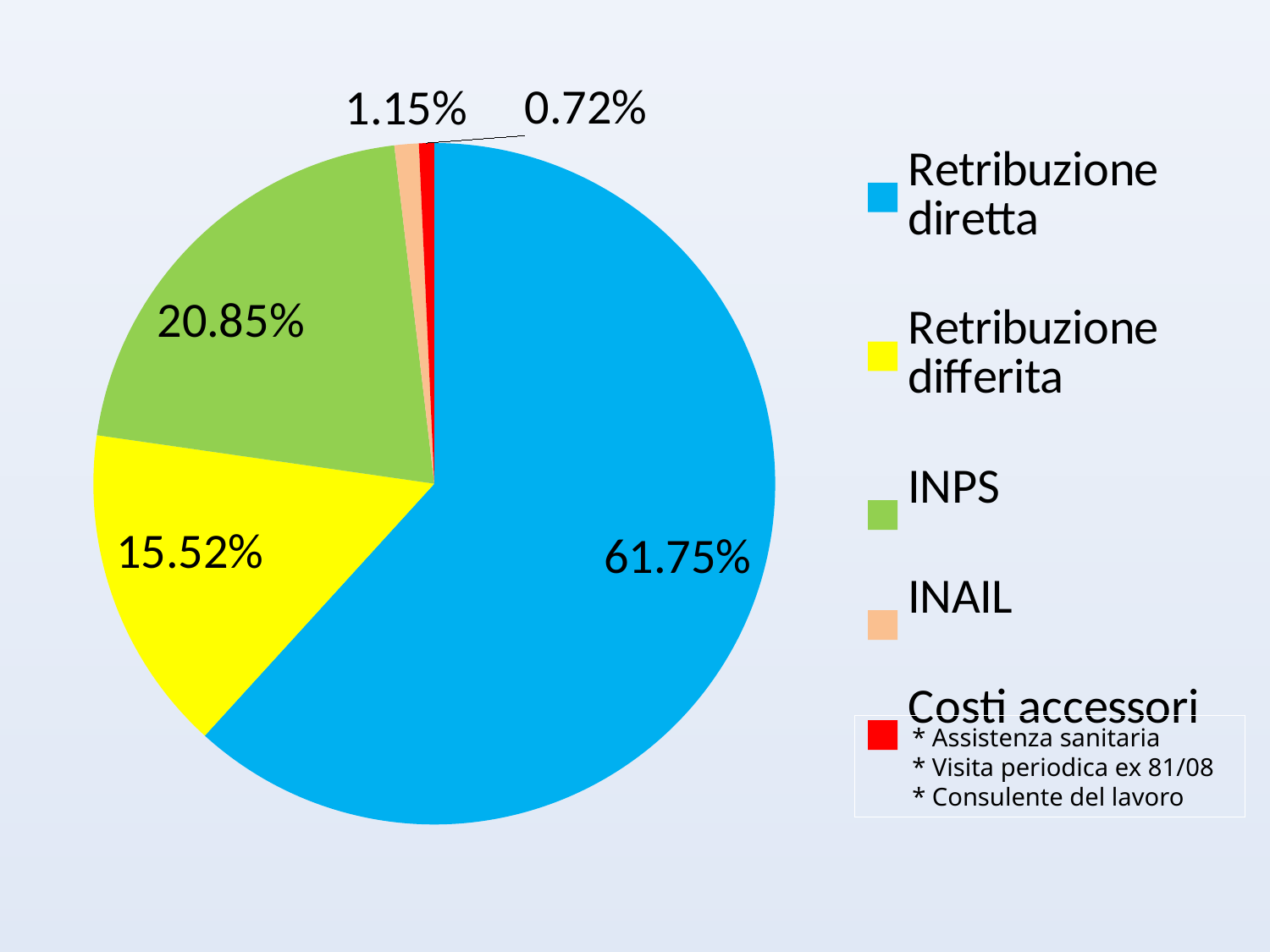
What is the value shown for INPS? 20.85% Which is larger, the INPS slice or the Retribuzione differita slice? INPS How many categories does the legend list? 5 What is the value shown for INAIL? 1.15% What kind of chart is shown on the slide? pie chart What share of the pie does Retribuzione diretta have? 61.75% What is the difference between the INPS share and the Retribuzione differita share? 5.33% What is the value shown for Retribuzione differita? 15.52% What is the value shown for Costi accessori? 0.72% What colour is the slice for INAIL? orange Which category has the largest slice of the pie? Retribuzione diretta Which category has the smallest slice of the pie? Costi accessori